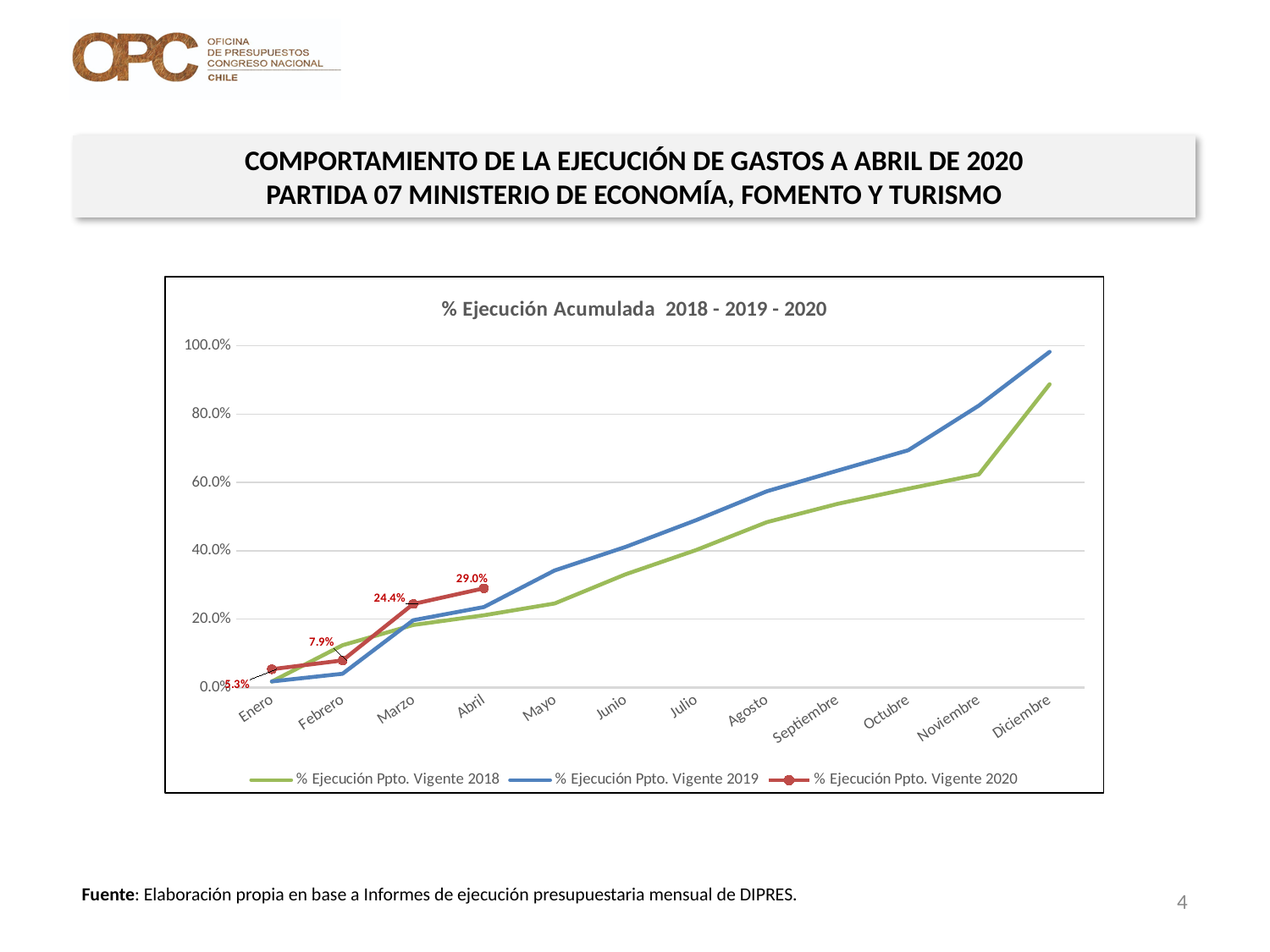
What is the value of % Ejecución Ppto. Vigente 2020 for Abril? 29.0% How many months are shown on the x axis? 12 What kind of chart is shown on the slide? Line chart In Diciembre, which series is higher: % Ejecución Ppto. Vigente 2019 or % Ejecución Ppto. Vigente 2018? % Ejecución Ppto. Vigente 2019 Among the labelled 2020 points, which month has the highest value? Abril How many series does the legend list? 3 What is the value of % Ejecución Ppto. Vigente 2020 for Marzo? 24.4% What is the value of % Ejecución Ppto. Vigente 2020 for Enero? 5.3% What is the difference between the 2020 values for Abril and Marzo? 4.6% What is the value of % Ejecución Ppto. Vigente 2020 for Febrero? 7.9% Is the value of % Ejecución Ppto. Vigente 2018 for Mayo greater or less than 40.0%? less Is the value of % Ejecución Ppto. Vigente 2019 for Diciembre greater or less than 80.0%? greater